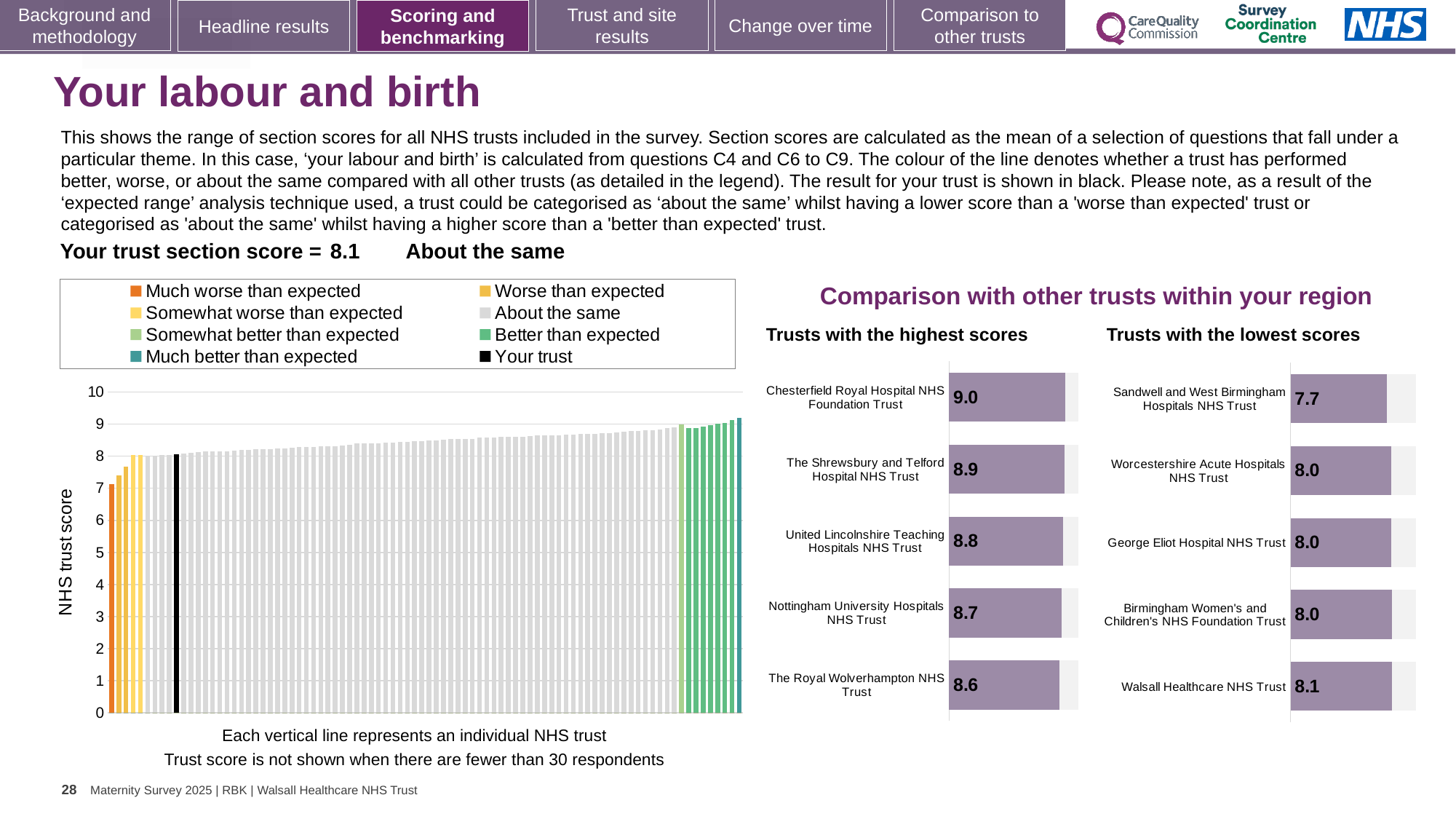
How many trusts are shown in the 'Trusts with the highest scores' chart? 5 In the 'Trusts with the highest scores' chart, what is the score for Chesterfield Royal Hospital NHS Foundation Trust? 9.0 In the 'Trusts with the lowest scores' chart, what is the score for Walsall Healthcare NHS Trust? 8.1 In the 'Trusts with the highest scores' chart, which has the higher score: The Shrewsbury and Telford Hospital NHS Trust or Nottingham University Hospitals NHS Trust? The Shrewsbury and Telford Hospital NHS Trust In the 'Trusts with the highest scores' chart, what is the difference between the scores of Chesterfield Royal Hospital NHS Foundation Trust and The Royal Wolverhampton NHS Trust? 0.4 In the 'Trusts with the lowest scores' chart, which trust has the lowest score? Sandwell and West Birmingham Hospitals NHS Trust How many entries does the legend of the 'NHS trust score' chart on the left list? 8 In the 'Trusts with the lowest scores' chart, what is the score for Sandwell and West Birmingham Hospitals NHS Trust? 7.7 What kind of chart is the 'NHS trust score' chart on the left of the slide? Bar chart In the 'Trusts with the lowest scores' chart, what is the difference between the scores of Walsall Healthcare NHS Trust and Sandwell and West Birmingham Hospitals NHS Trust? 0.4 In the 'NHS trust score' chart on the left, do the values rise or fall from left to right? Rise In the 'Trusts with the highest scores' chart, which trust has the highest score? Chesterfield Royal Hospital NHS Foundation Trust